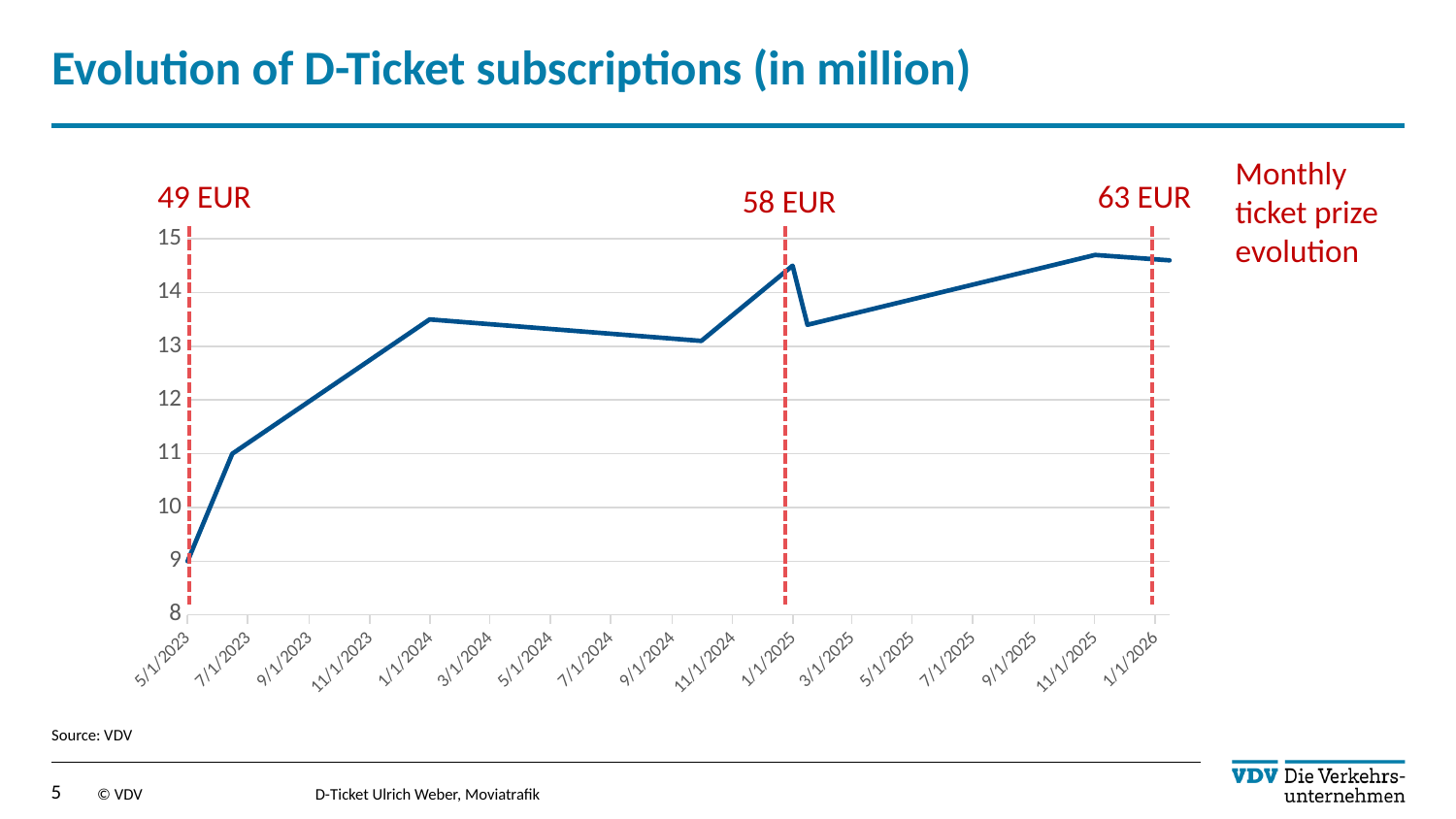
Which date has the lowest number of subscriptions? 5/1/2023 Overall, do subscriptions rise or fall from 5/1/2023 to 1/1/2026? rise Is the value for 1/1/2024 greater or less than 13? greater What monthly ticket price is marked at 1/1/2025? 58 EUR Is the value for 5/1/2023 greater or less than 10? less What is the value for 7/1/2023? 11 What kind of chart is shown on the slide? line chart Is the value for 11/1/2025 greater or less than 14? greater How many ticket price markers (dashed red lines) are shown on the chart? 3 Which is larger, the value for 7/1/2023 or the value for 1/1/2024? 1/1/2024 What is the title of the chart? Evolution of D-Ticket subscriptions (in million)